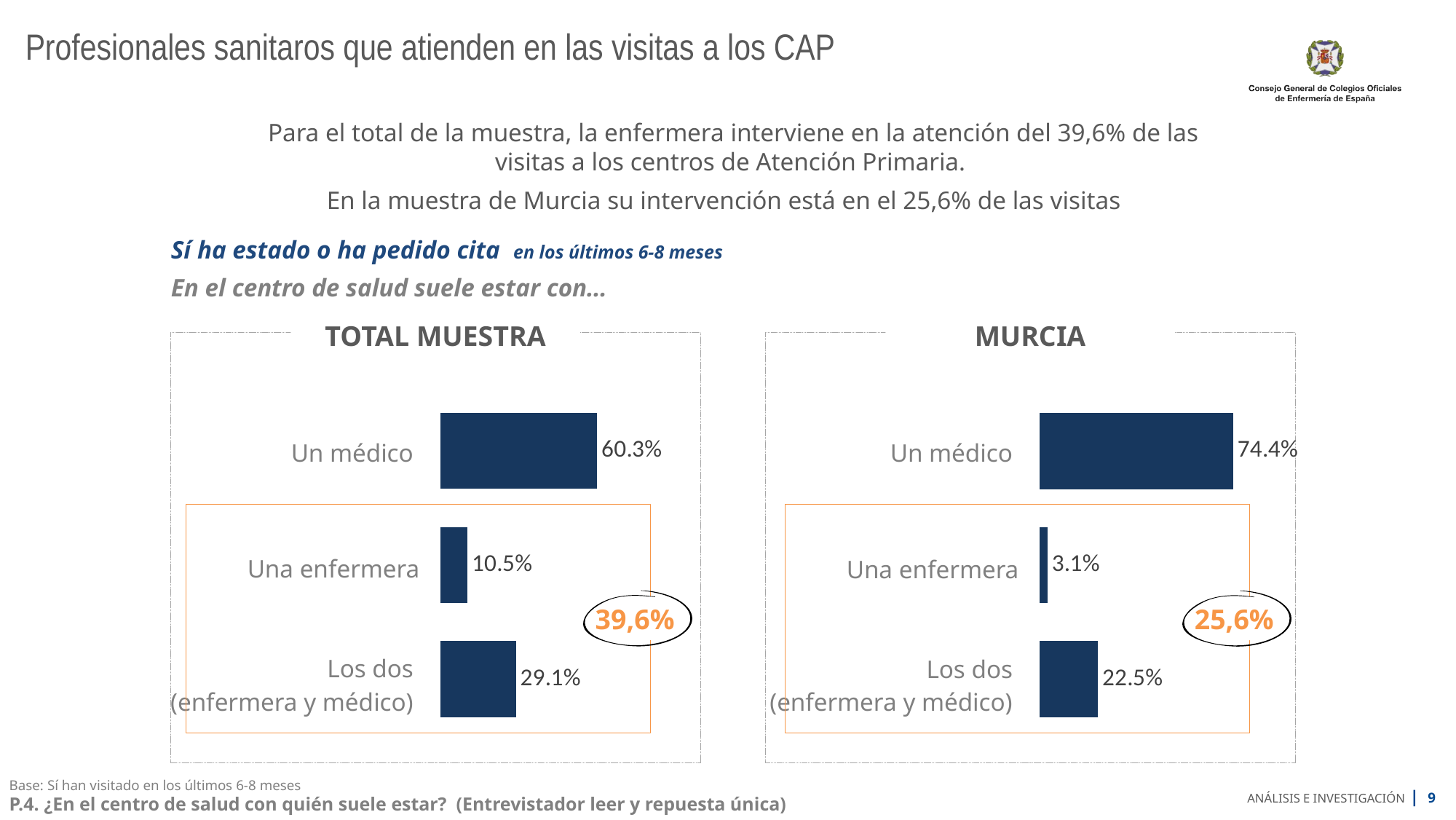
Which is larger: Una enfermera in the TOTAL MUESTRA chart or Una enfermera in the MURCIA chart? TOTAL MUESTRA In the MURCIA chart, what is the difference between Un médico and Una enfermera? 71.3% In the MURCIA chart, what is the value for Los dos (enfermera y médico)? 22.5% How many categories does the TOTAL MUESTRA chart show? 3 In the TOTAL MUESTRA chart, what is the difference between Un médico and Los dos (enfermera y médico)? 31.2% In the MURCIA chart, which category has the highest value? Un médico What is the circled percentage shown next to the MURCIA chart? 25,6% In the TOTAL MUESTRA chart, which category has the lowest value? Una enfermera In the MURCIA chart, what is the value for Una enfermera? 3.1% What kind of chart is the MURCIA chart? Bar chart In the TOTAL MUESTRA chart, what is the value for Un médico? 60.3% In the TOTAL MUESTRA chart, what is the value for Una enfermera? 10.5%